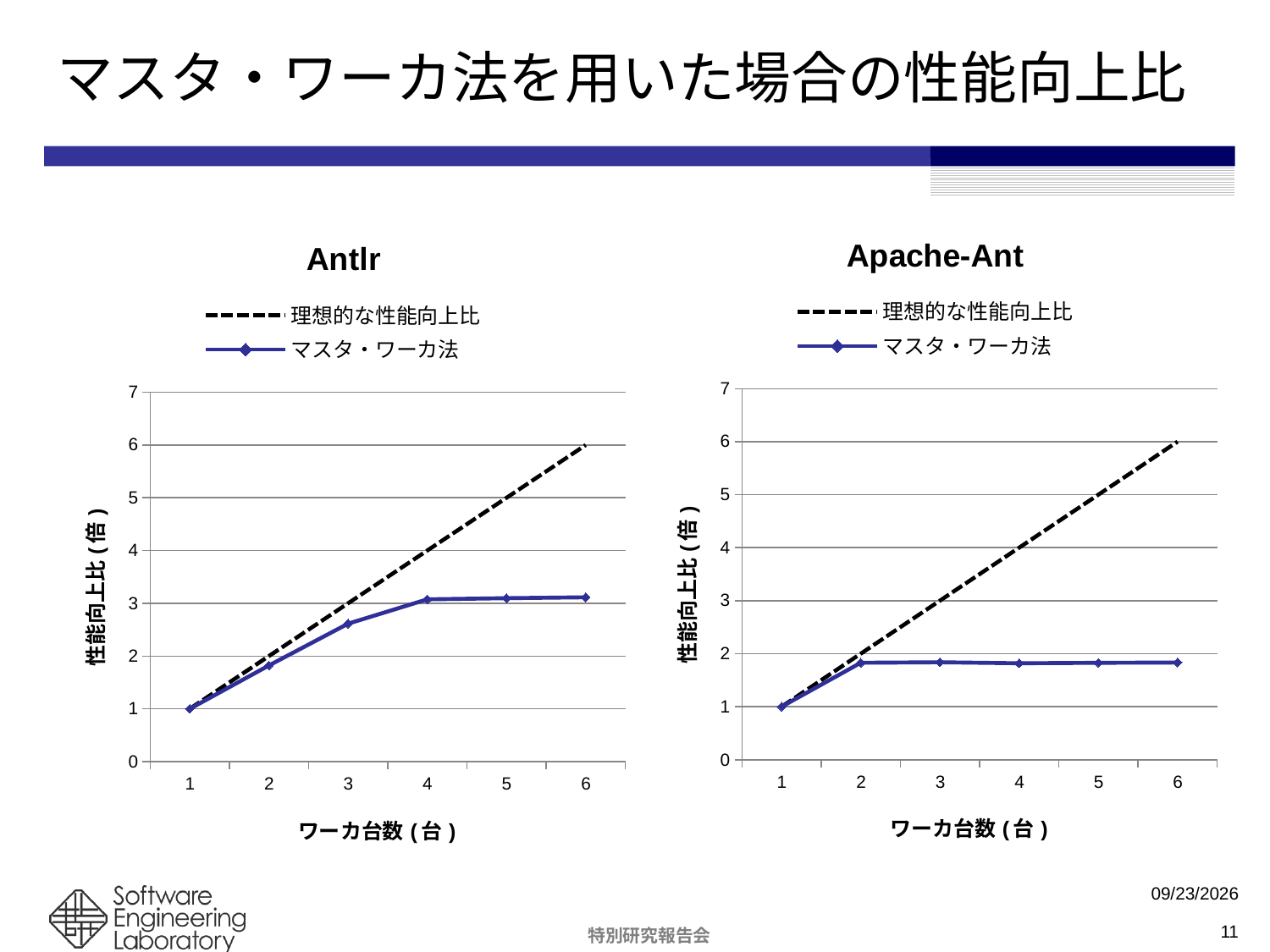
In the Apache-Ant chart, is the value of マスタ・ワーカ法 at 6 workers greater or less than 2? less What type of chart is the Antlr chart? line chart In the Antlr chart, is the value of マスタ・ワーカ法 at 6 workers greater or less than 4? less In the Antlr chart, which series has the larger value at 6 workers, 理想的な性能向上比 or マスタ・ワーカ法? 理想的な性能向上比 In the Apache-Ant chart, what is the value of マスタ・ワーカ法 at 1 worker? 1 In the Apache-Ant chart, is the value of マスタ・ワーカ法 at 4 workers greater or less than 1? greater How many worker counts (x-axis points) are plotted in the Antlr chart? 6 In the Apache-Ant chart, does the マスタ・ワーカ法 line rise, fall, or stay roughly flat from 2 workers to 6 workers? stay roughly flat How many series does the legend of the Apache-Ant chart list? 2 At 6 workers, which chart shows the larger value for マスタ・ワーカ法, Antlr or Apache-Ant? Antlr In the Antlr chart, what is the value of 理想的な性能向上比 at 6 workers? 6 What is the x-axis label of the Antlr chart? ワーカ台数 (台)